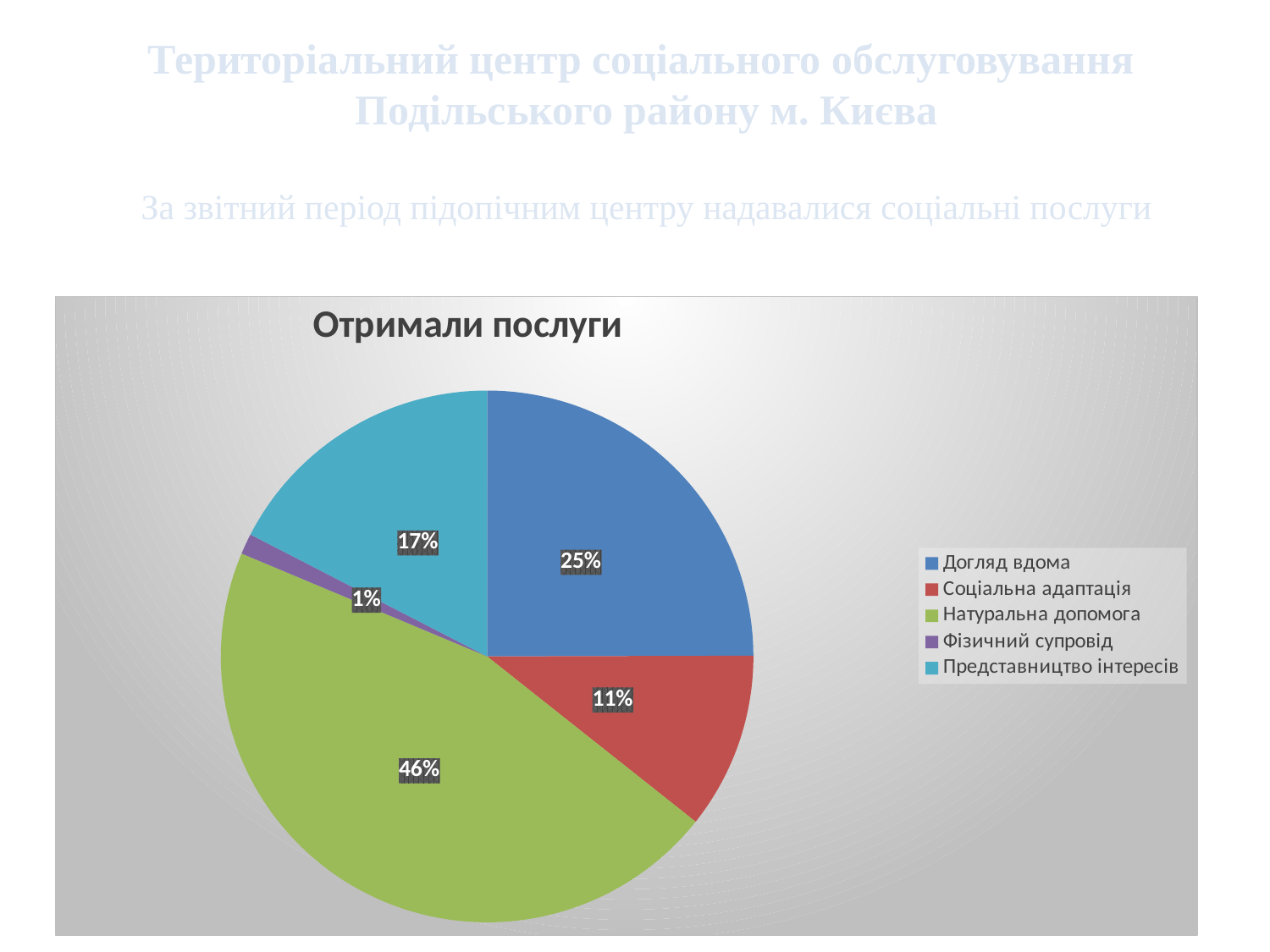
What share of the pie does Догляд вдома have? 25% How many categories does the legend list? 5 What is the difference in percentage points between Натуральна допомога and Догляд вдома? 21 Which category has the largest slice of the pie? Натуральна допомога What share of the pie does Соціальна адаптація have? 11% What share of the pie does Фізичний супровід have? 1% What is the title of the chart? Отримали послуги Which category has the smallest slice of the pie? Фізичний супровід What kind of chart is shown on the slide? pie chart Which is larger, the share for Догляд вдома or the share for Представництво інтересів? Догляд вдома